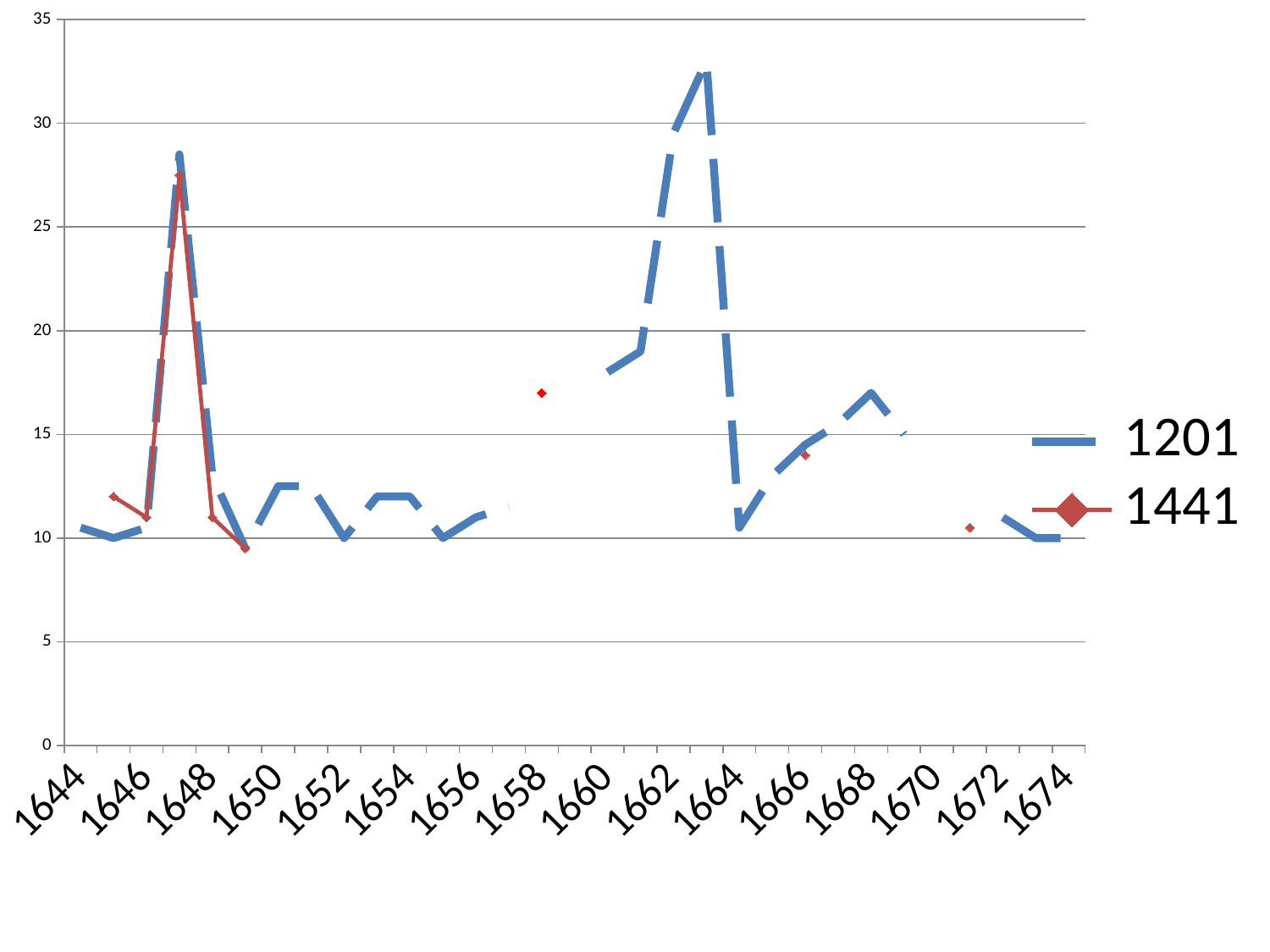
Is the highest value of series 1201 greater or less than 30? greater How many year labels are shown along the x axis? 16 Does series 1201 rise or fall between 1662 and 1664? fall Is the value of series 1441 at 1658 greater or less than 15? greater How many series does the legend list? 2 Is the value of series 1201 at 1664 greater or less than 15? less What kind of chart is shown on the slide? line chart Which series reaches the higher peak value, 1201 or 1441? 1201 What are the two series named in the legend? 1201 and 1441 What colour is the line for series 1201? blue